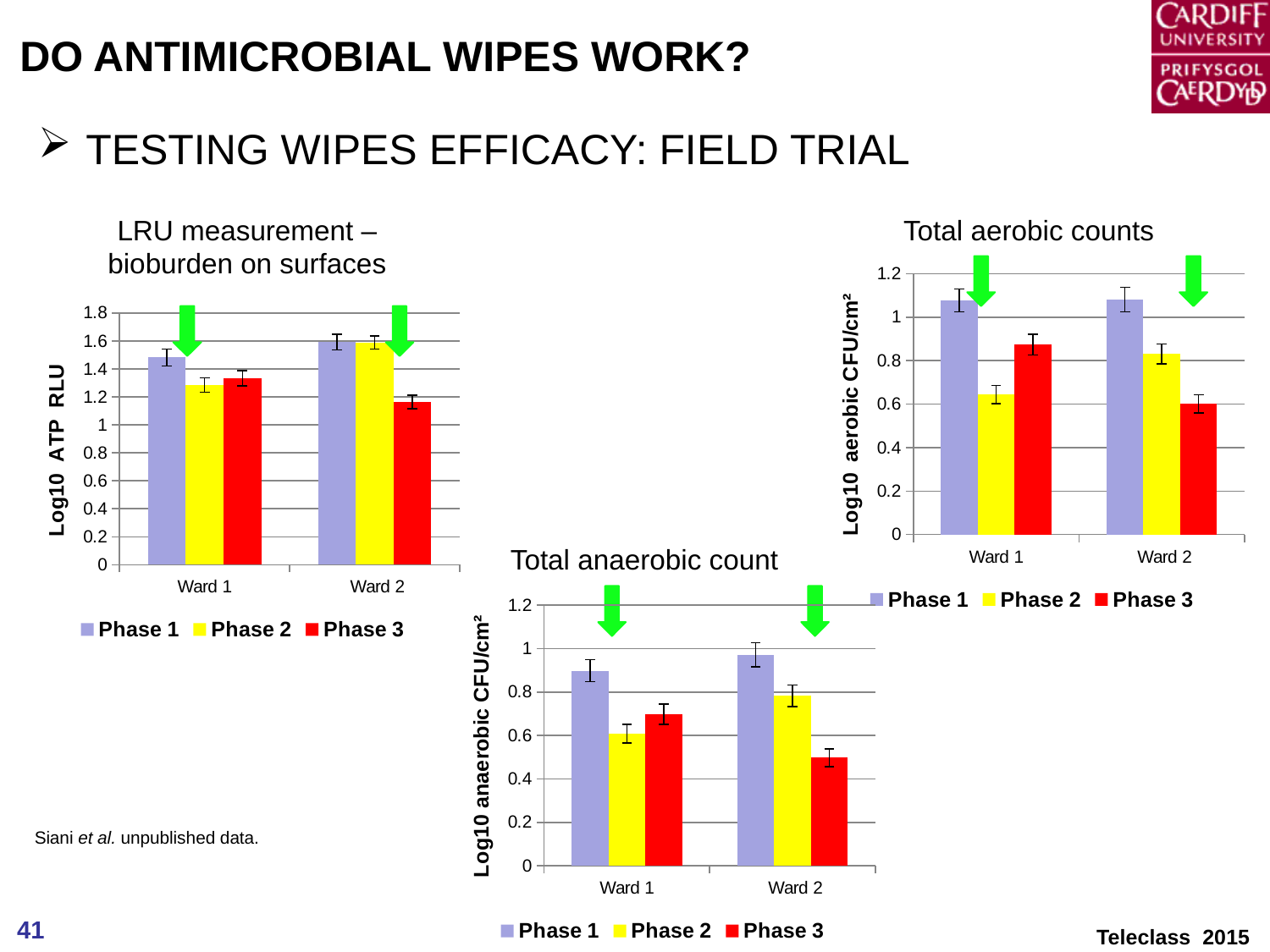
In the 'Total aerobic counts' chart, which phase has the highest value in Ward 2? Phase 1 What is the y-axis label of the 'Total anaerobic count' chart? Log10 anaerobic CFU/cm² In the 'Total aerobic counts' chart, is the value for Phase 2 in Ward 1 greater or less than 0.8? less In the 'Total aerobic counts' chart, which phase has the lowest value in Ward 1? Phase 2 In the 'Total anaerobic count' chart, is the value for Phase 1 in Ward 1 greater or less than 0.8? greater In the 'Total anaerobic count' chart, is the value for Phase 3 in Ward 2 greater or less than 0.6? less In the 'Total aerobic counts' chart, how many series does the legend list? 3 What kind of chart is the 'LRU measurement – bioburden on surfaces' chart? bar chart In the 'Total anaerobic count' chart, how many ward categories are shown on the x axis? 2 In the 'LRU measurement – bioburden on surfaces' chart, which phase has the lowest value in Ward 2? Phase 3 In the 'LRU measurement – bioburden on surfaces' chart, which is larger for Ward 2: Phase 1 or Phase 3? Phase 1